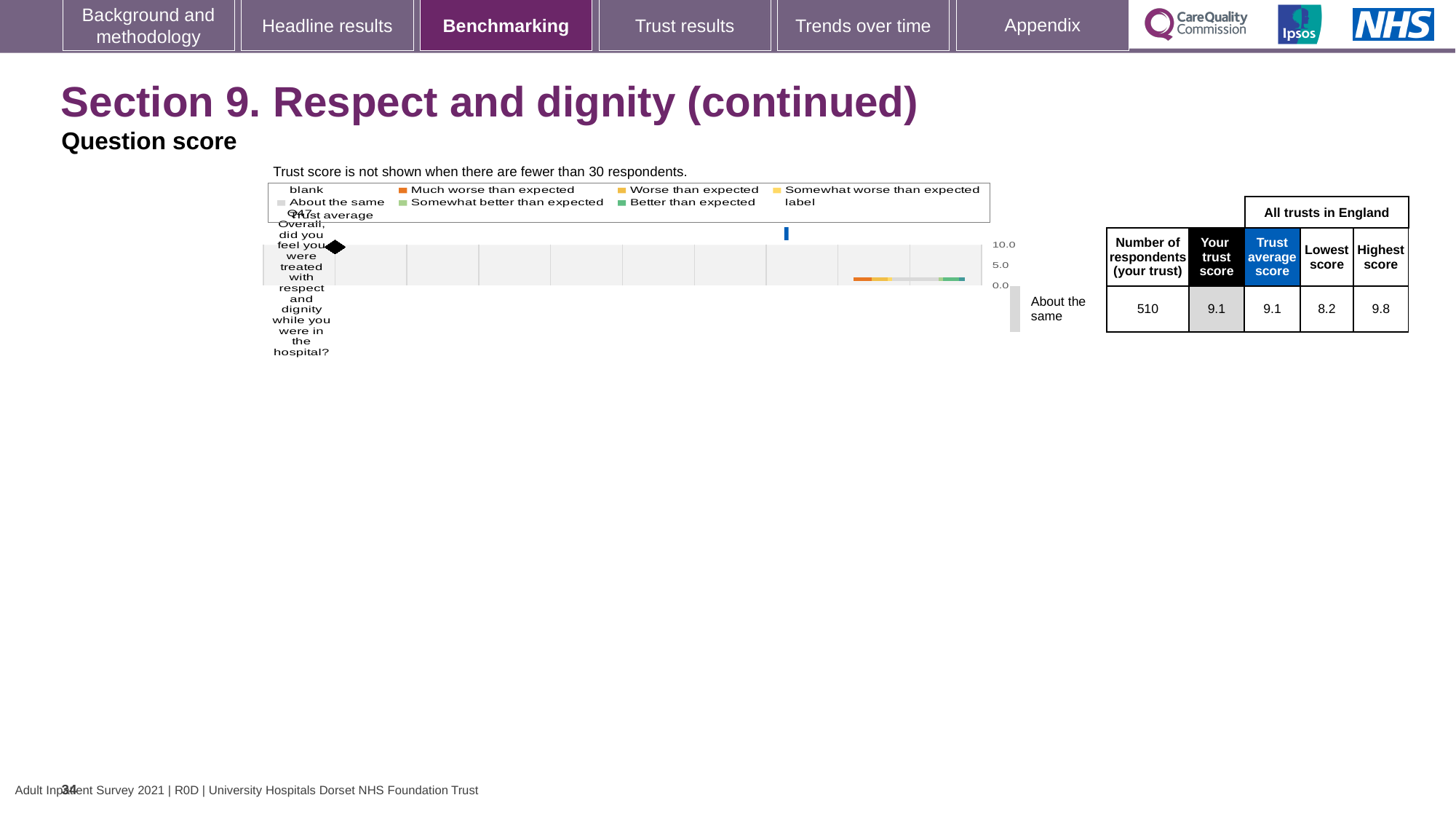
How many survey questions are plotted on the chart? 1 Is the trust score for Q47 greater or less than 5.0 on the chart's axis? greater What is the trust score for Q47 shown in the table next to the chart? 9.1 What is the highest score across all trusts in England for Q47? 9.8 What is the difference between the highest score and the lowest score for Q47? 1.6 How many respondents from the trust answered Q47? 510 What is the highest tick value shown on the chart's score axis? 10.0 What is the trust average score for Q47 shown in the table? 9.1 What is the lowest score across all trusts in England for Q47? 8.2 Which question number is plotted on the chart? Q47 What benchmark category is the trust's Q47 score labelled as? About the same What kind of chart is shown on the slide? bar chart